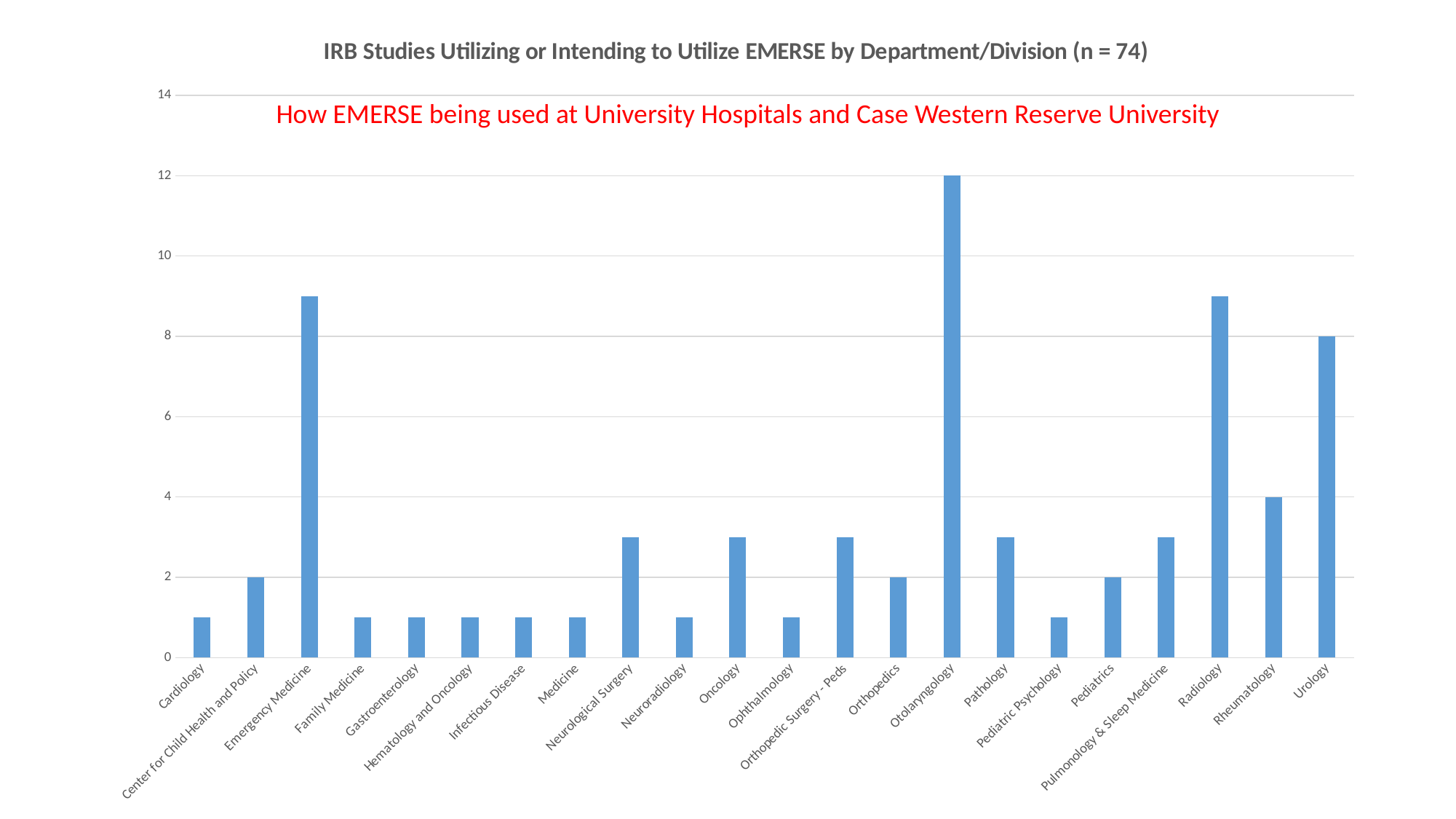
How many IRB studies are shown for Rheumatology? 4 What is the difference between the values for Otolaryngology and Urology? 4 Is the value for Cardiology greater or less than 2? less How many IRB studies are shown for Orthopedics? 2 How many departments/divisions are shown on the x axis? 22 Which department/division has the highest number of IRB studies? Otolaryngology How many IRB studies are shown for Urology? 8 Which has a larger value, Otolaryngology or Radiology? Otolaryngology What type of chart is shown on the slide? Bar chart Is the value for Emergency Medicine greater or less than 8? greater How many IRB studies are shown for Otolaryngology? 12 What is the title of the chart? IRB Studies Utilizing or Intending to Utilize EMERSE by Department/Division (n = 74)